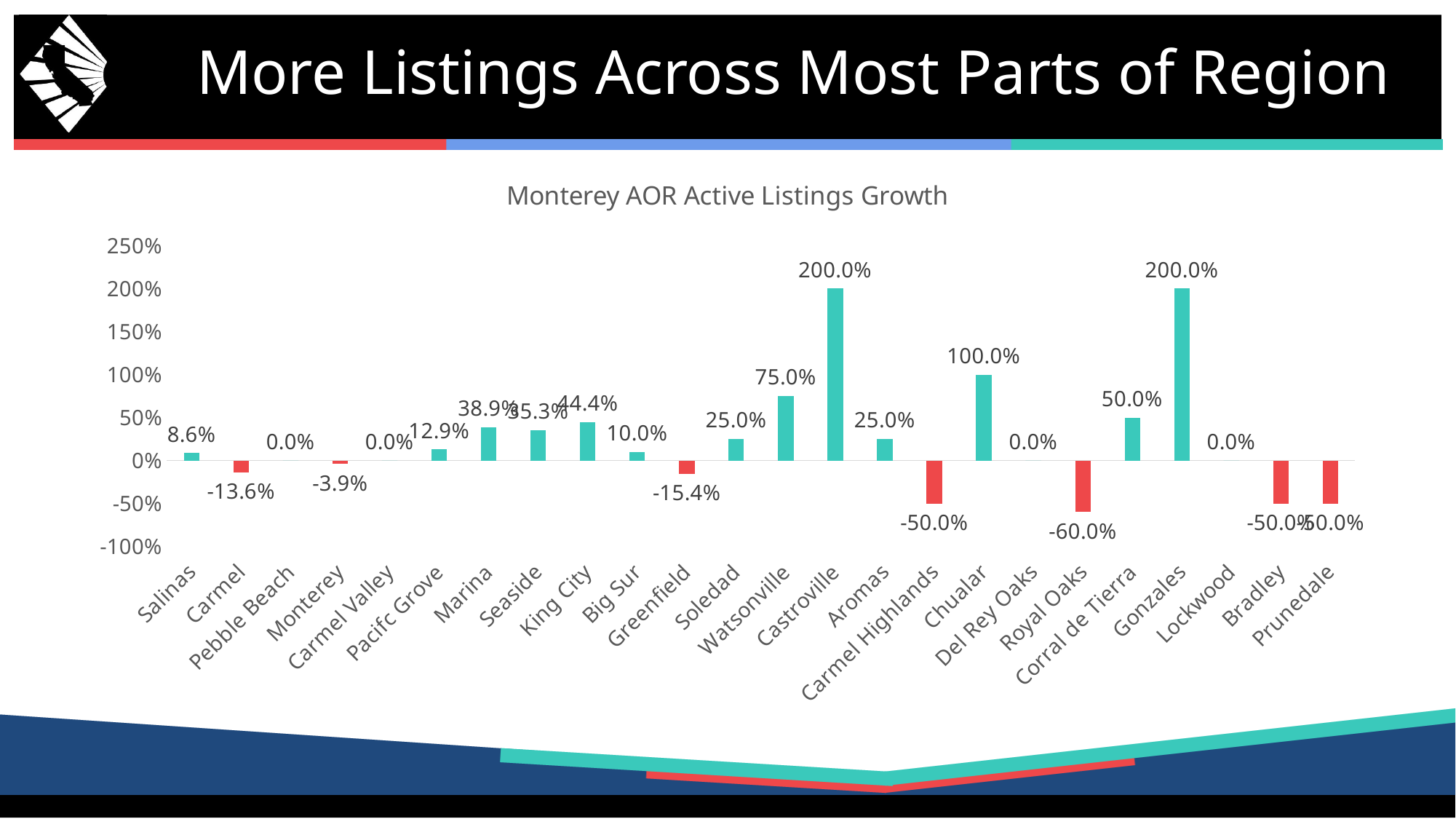
Which area has the lowest active listings growth? Royal Oaks How many areas are shown on the x axis of the chart? 24 What is the active listings growth value for Watsonville? 75.0% What is the difference between the growth values for Chualar and Corral de Tierra? 50.0% What is the active listings growth value for Carmel? -13.6% What is the active listings growth value for King City? 44.4% Which has the higher active listings growth, Soledad or Watsonville? Watsonville Which has the higher active listings growth, Greenfield or Monterey? Monterey What is the difference between the growth values for Marina and Seaside? 3.6% What is the active listings growth value for Royal Oaks? -60.0% What kind of chart is shown on the slide? Bar chart What is the title of the chart? Monterey AOR Active Listings Growth